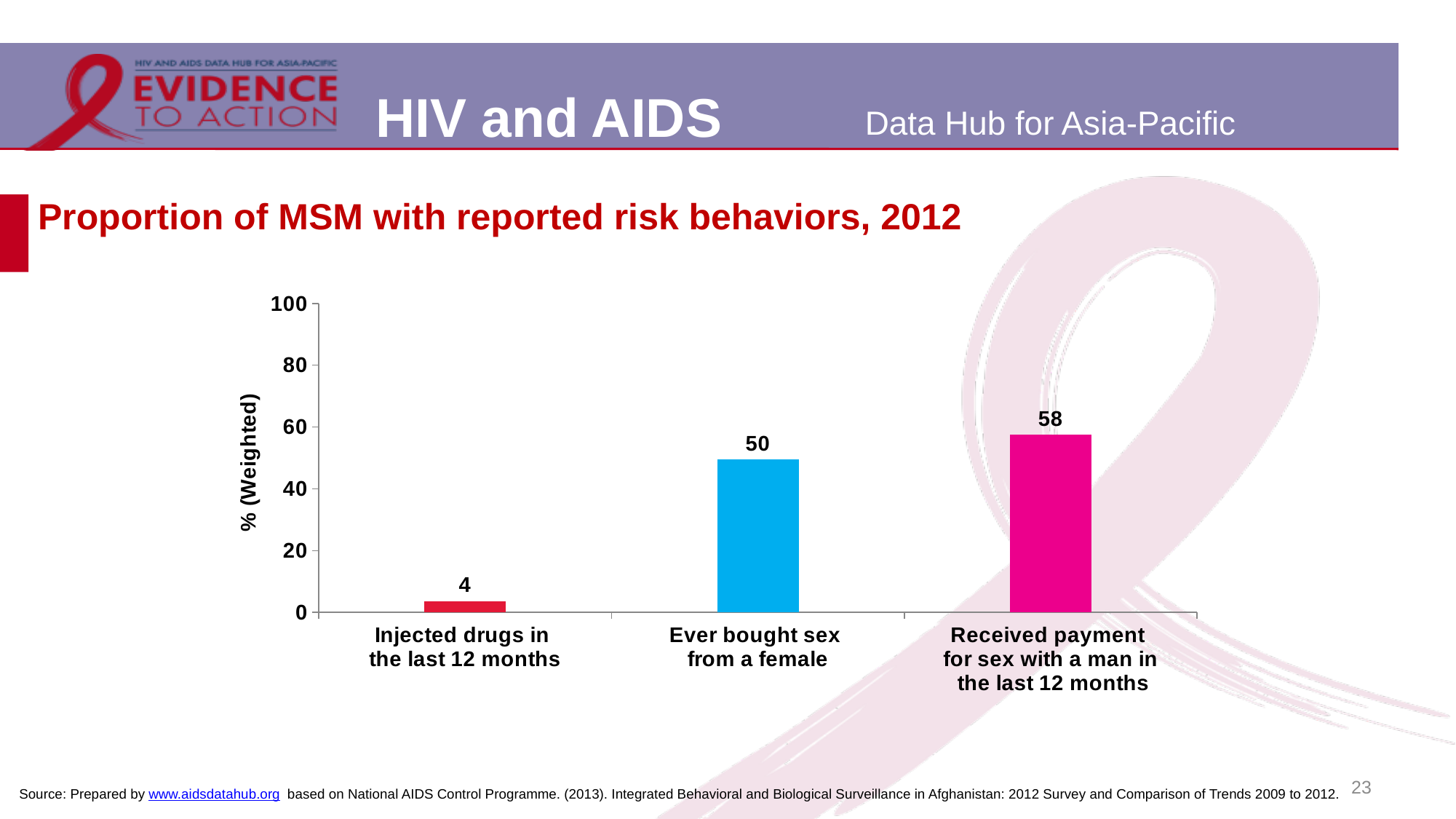
What is the value for 'Ever bought sex from a female'? 50 What is the value for 'Injected drugs in the last 12 months'? 4 What kind of chart is shown on the slide? Bar chart Is the value for 'Received payment for sex with a man in the last 12 months' greater or less than 40? greater How many categories are shown in the chart? 3 Which category has the highest value? Received payment for sex with a man in the last 12 months What is the difference between the values for 'Received payment for sex with a man in the last 12 months' and 'Ever bought sex from a female'? 8 What is the label of the vertical axis? % (Weighted) What is the difference between the values for 'Ever bought sex from a female' and 'Injected drugs in the last 12 months'? 46 Which category has the lowest value? Injected drugs in the last 12 months What is the value for 'Received payment for sex with a man in the last 12 months'? 58 Which is larger: the value for 'Ever bought sex from a female' or 'Injected drugs in the last 12 months'? Ever bought sex from a female